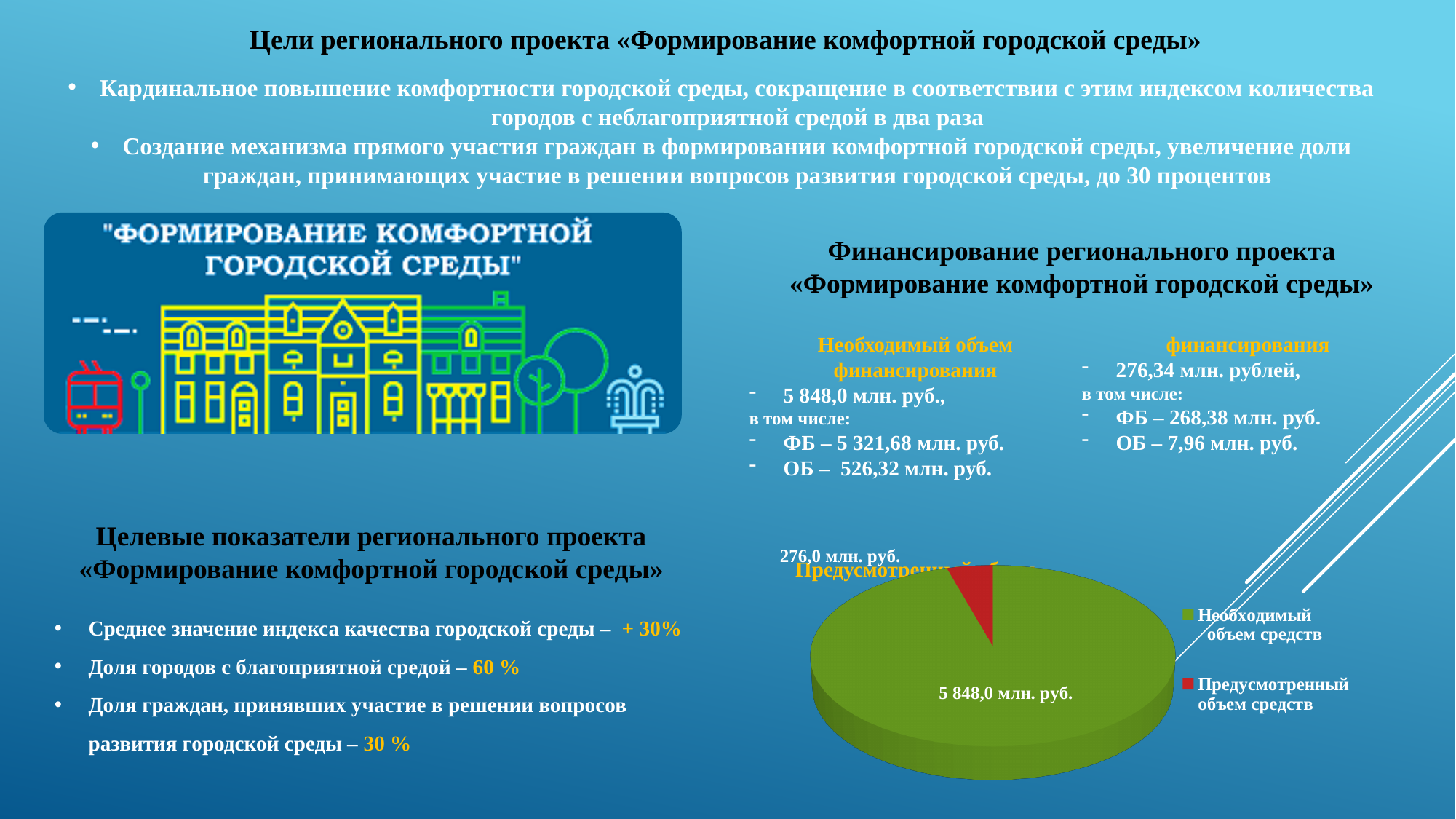
What colour is the «Предусмотренный объем средств» slice in the pie chart? Red Which slice of the pie chart is the smallest? Предусмотренный объем средств How many entries does the pie chart's legend list? 2 In the pie chart, which is larger: «Необходимый объем средств» or «Предусмотренный объем средств»? Необходимый объем средств By how much does «Необходимый объем средств» exceed «Предусмотренный объем средств» in the pie chart? 5 572,0 млн. руб. What is the total of the two values labelled on the pie chart? 6 124,0 млн. руб. How many slices does the pie chart have? 2 What value is labelled on the pie chart for «Предусмотренный объем средств»? 276,0 млн. руб. What value is labelled on the pie chart for «Необходимый объем средств»? 5 848,0 млн. руб. Which slice of the pie chart is the largest? Необходимый объем средств What kind of chart is shown on the slide? Pie chart What colour is the «Необходимый объем средств» slice in the pie chart? Green